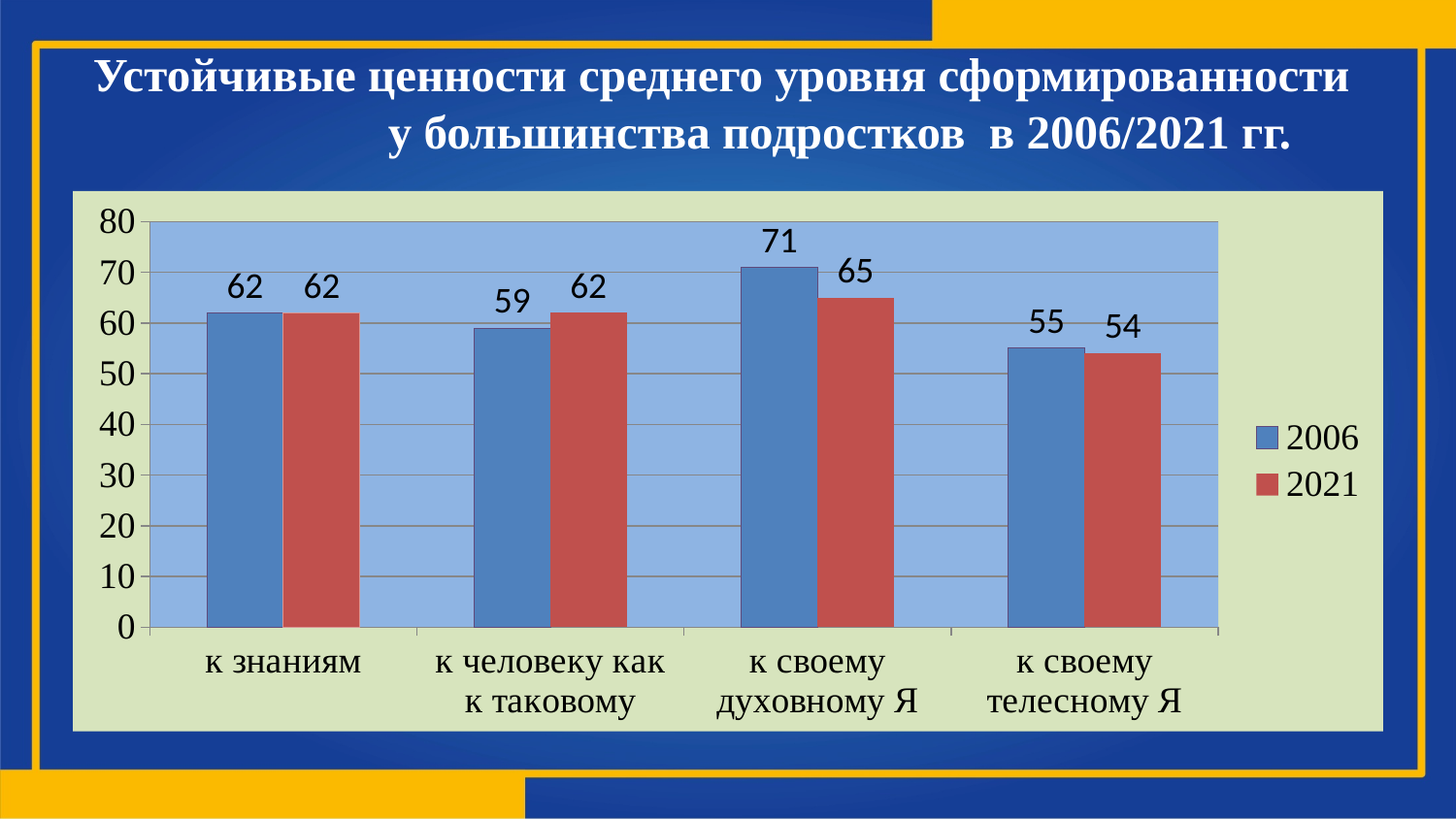
What kind of chart is shown on the slide? bar chart Which series is shown in red in the legend? 2021 Is the 2006 value for 'к своему телесному Я' greater or less than 60? less What is the value for 2021 for the category 'к своему телесному Я'? 54 How many categories are shown on the x axis? 4 How many series does the legend list? 2 Which category has the lowest value for 2021? к своему телесному Я Which category has the highest value for 2006? к своему духовному Я Which is larger for 'к человеку как к таковому': the 2006 value or the 2021 value? 2021 What is the value for 2006 for the category 'к своему духовному Я'? 71 What is the difference between the 2006 and 2021 values for 'к своему духовному Я'? 6 What is the value for 2021 for the category 'к человеку как к таковому'? 62